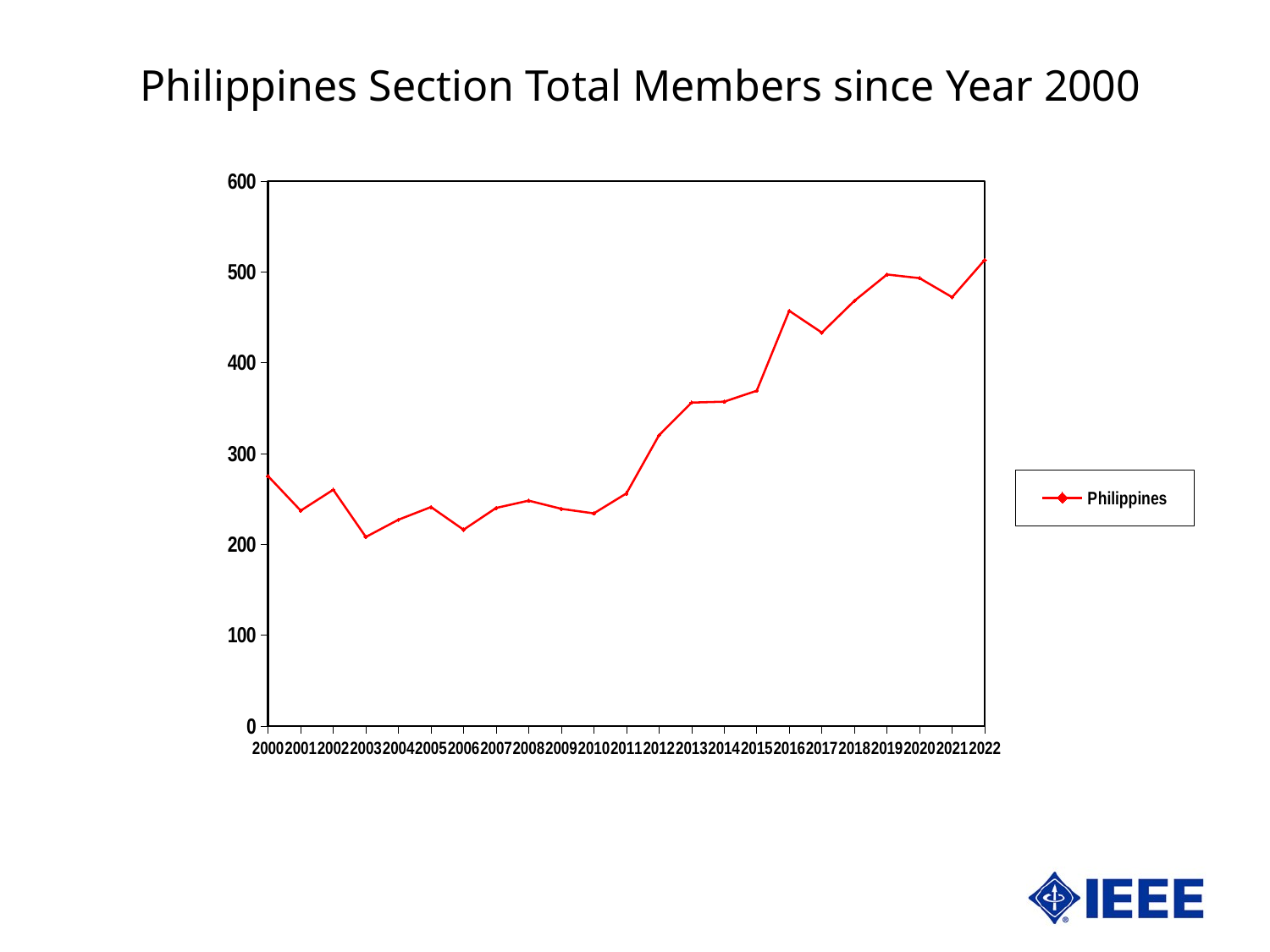
Is the value for 2013 greater or less than 400? less What is the title of the chart? Philippines Section Total Members since Year 2000 Which year has the larger value, 2016 or 2017? 2016 How many series does the legend list? 1 Is the value for 2000 greater or less than 300? less Which year has the highest number of members? 2022 What kind of chart is shown on the slide? line chart Overall, do the values rise or fall from 2000 to 2022? rise Is the value for 2016 greater or less than 400? greater How many years are plotted along the x axis? 23 What is the name of the series shown in the legend? Philippines